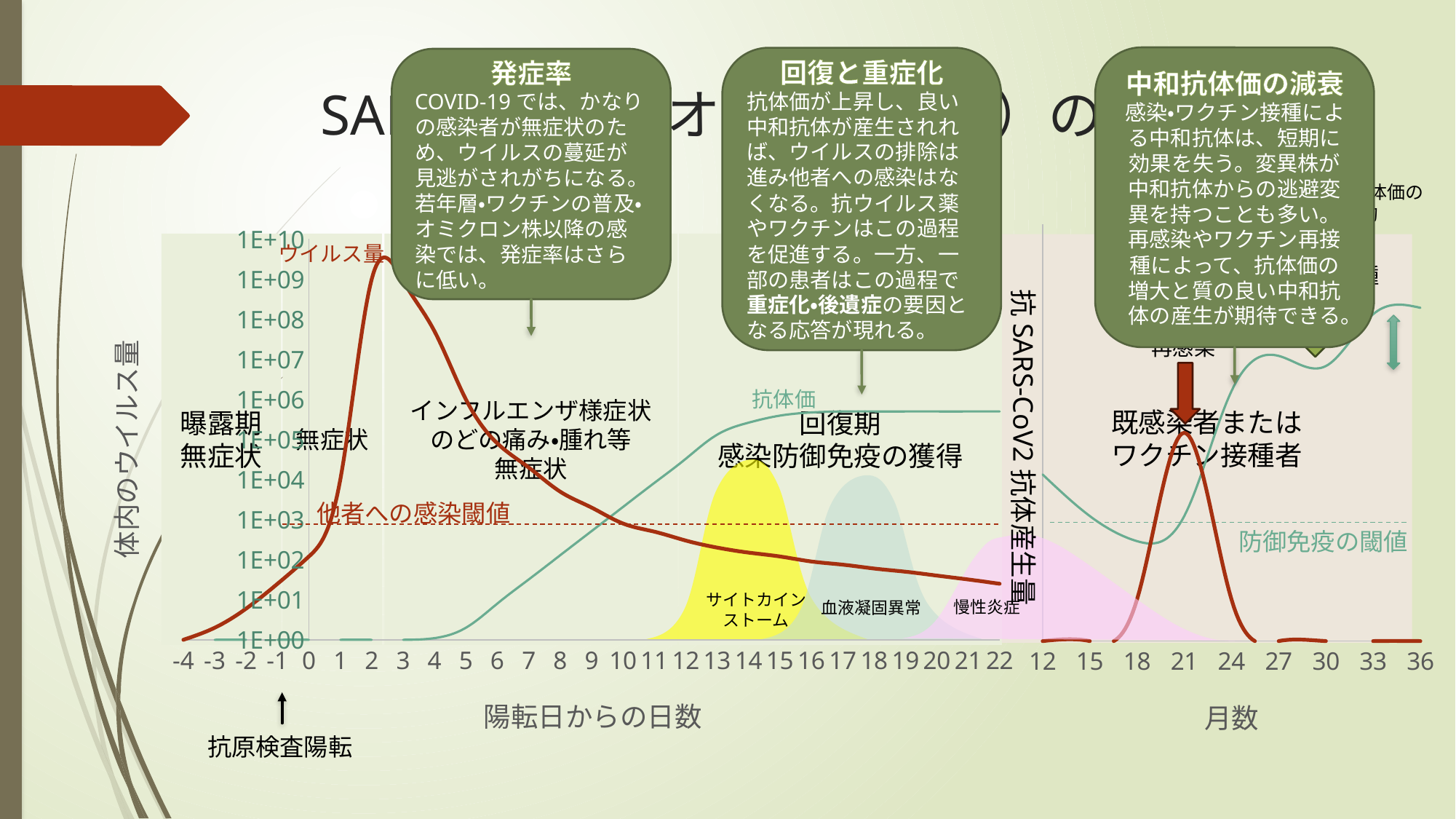
Is the viral load (ウイルス量) at day 2 greater or less than 1E+08? greater Is the viral load (ウイルス量) at day 14 greater or less than 1E+03? less What is the highest value shown on the y axis of the chart? 1E+10 Does the antibody titer (抗体価) rise or fall between day 4 and day 14? rise Does the viral load (ウイルス量) rise or fall between day -4 and day 2? rise Does the viral load (ウイルス量) rise or fall between day 2 and day 22? fall At which y-axis value is the dashed line 他者への感染閾値 drawn? 1E+03 What kind of chart is shown on the slide? line chart Is the viral load (ウイルス量) at day 22 greater or less than 1E+03? less What is the label of the y axis of the chart? 体内のウイルス量 What is the label of the left x axis (days) of the chart? 陽転日からの日数 What is the last value shown on the right x axis (月数) of the chart? 36